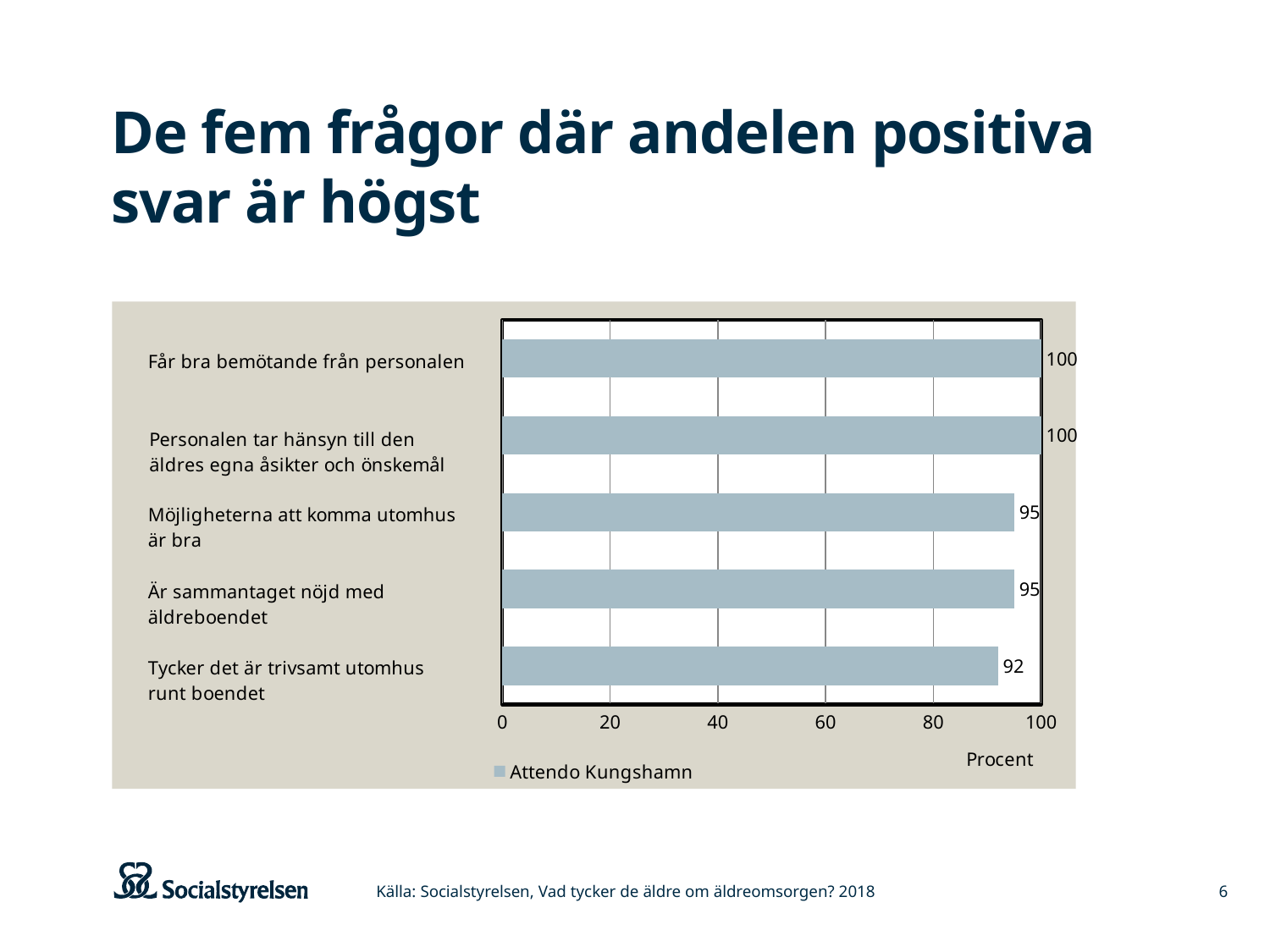
Which is larger: the value for "Personalen tar hänsyn till den äldres egna åsikter och önskemål" or the value for "Är sammantaget nöjd med äldreboendet"? Personalen tar hänsyn till den äldres egna åsikter och önskemål How many series does the legend list? 1 What is the value for "Får bra bemötande från personalen"? 100 How many categories are shown in the chart? 5 Which category has the lowest value? Tycker det är trivsamt utomhus runt boendet What kind of chart is shown on the slide? bar chart What is the difference between the value for "Får bra bemötande från personalen" and the value for "Tycker det är trivsamt utomhus runt boendet"? 8 What is the value for "Möjligheterna att komma utomhus är bra"? 95 What series name is shown in the legend? Attendo Kungshamn What is the difference between the value for "Är sammantaget nöjd med äldreboendet" and the value for "Tycker det är trivsamt utomhus runt boendet"? 3 Is the value for "Tycker det är trivsamt utomhus runt boendet" greater or less than 80? greater What is the value for "Tycker det är trivsamt utomhus runt boendet"? 92